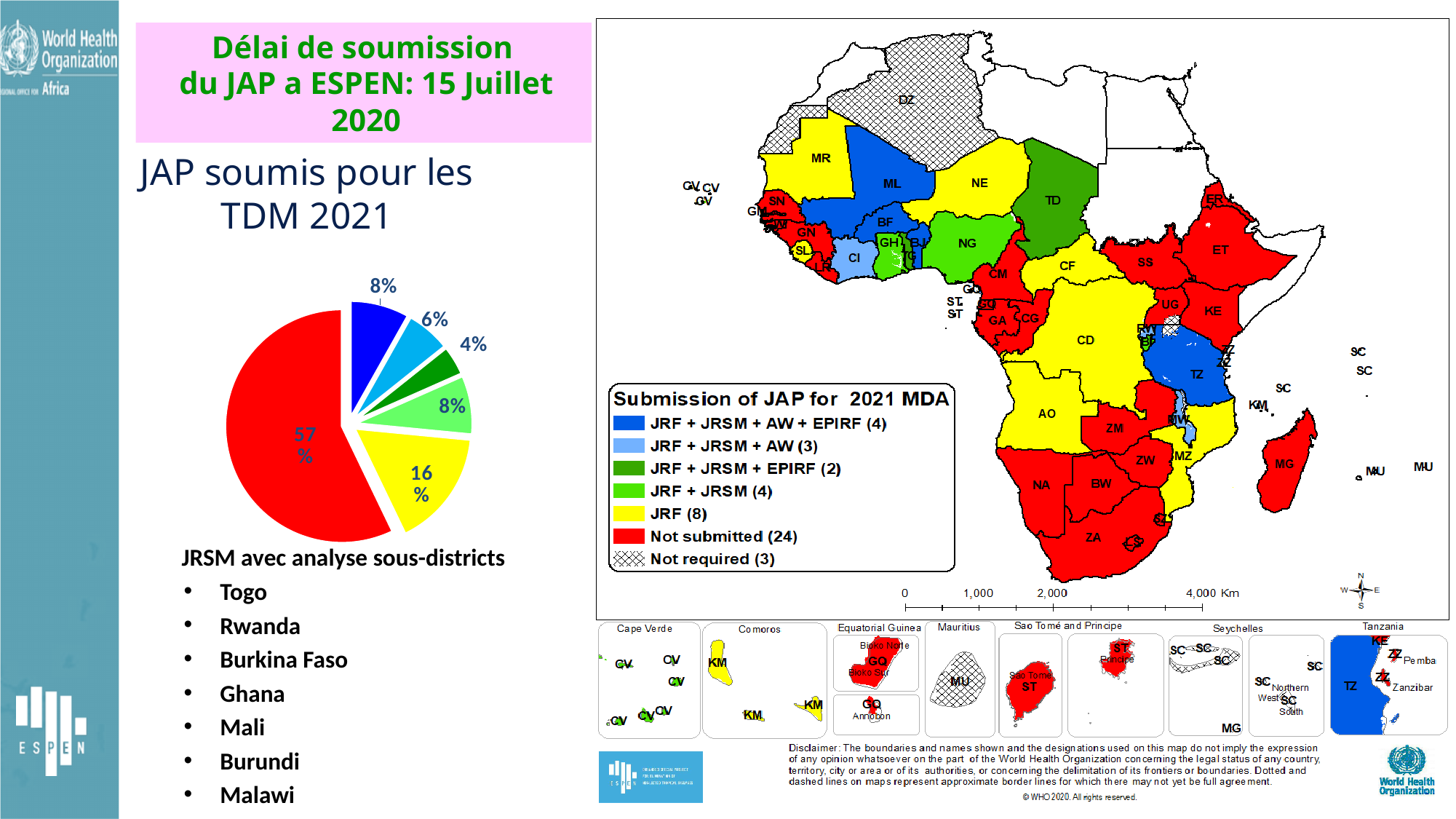
What is the smallest percentage shown on the pie chart? 4% What percentage is shown on the yellow slice of the pie chart? 16% How many slices does the pie chart have? 6 What is the difference in percentage points between the largest slice (57%) and the yellow slice (16%) of the pie chart? 41 What kind of chart is shown on the left of the slide under 'JAP soumis pour les TDM 2021'? pie chart What is the largest percentage shown on the pie chart? 57% What is the combined percentage of the two slices labelled 8% and the slice labelled 6% on the pie chart? 22% How many slices on the pie chart are labelled 8%? 2 Is the largest slice of the pie chart greater or less than 50%? greater What is the title of the map legend on the right of the slide? Submission of JAP for 2021 MDA What percentage is shown on the red slice of the pie chart? 57% Which is larger on the pie chart: the yellow slice or the light green slice? the yellow slice